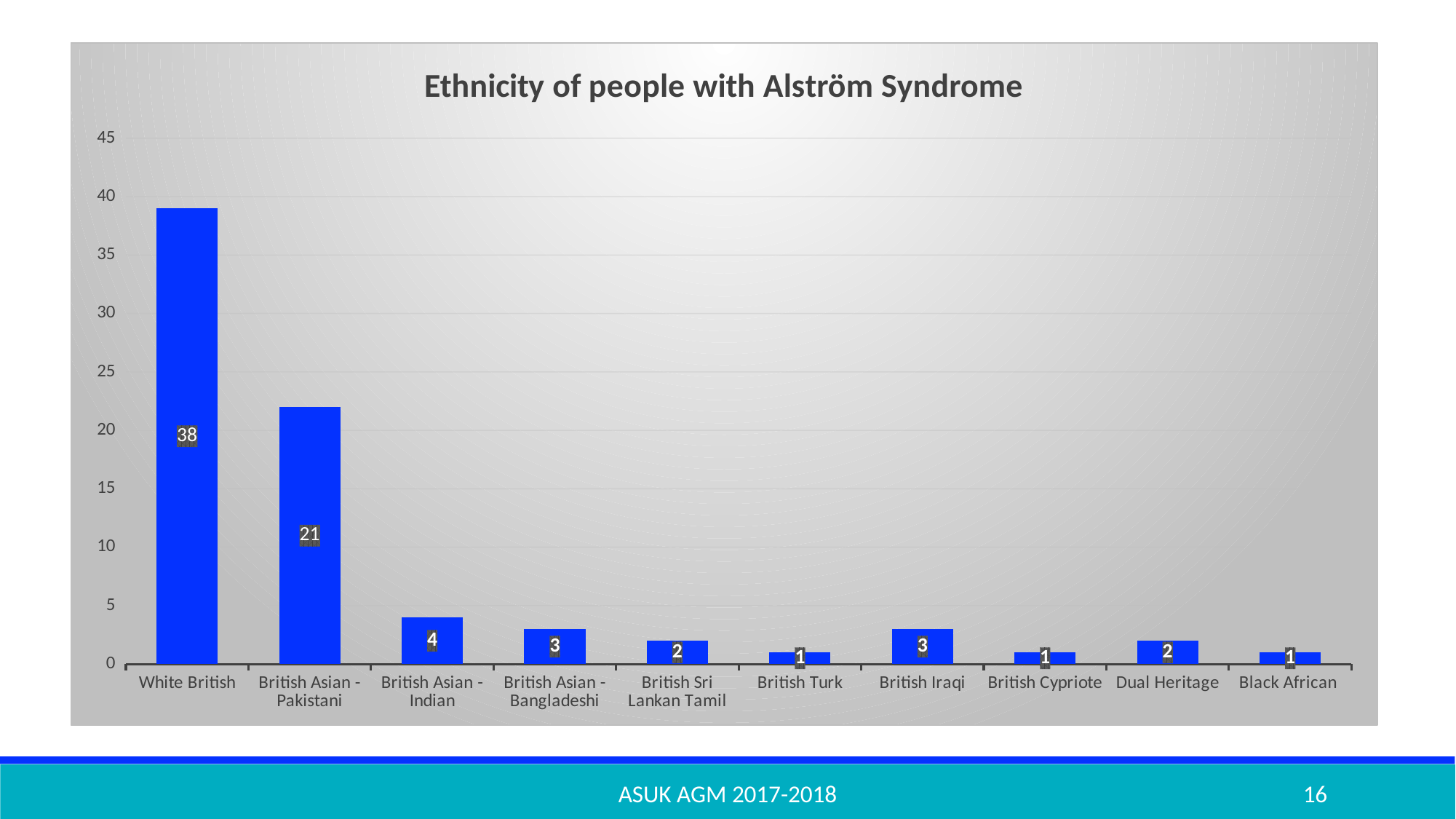
Is the value for British Asian - Pakistani greater or less than 25? less How many categories have a value of 1? 3 Which is larger, the value for British Asian - Indian or the value for British Asian - Bangladeshi? British Asian - Indian What is the value for Dual Heritage? 2 What is the difference between the values for White British and British Asian - Pakistani? 17 How many ethnicity categories are shown on the chart? 10 What is the value for British Iraqi? 3 Which ethnicity category has the highest value? White British What is the title of the chart? Ethnicity of people with Alström Syndrome What is the value for White British? 38 What kind of chart is shown on the slide? bar chart What is the value for British Asian - Pakistani? 21